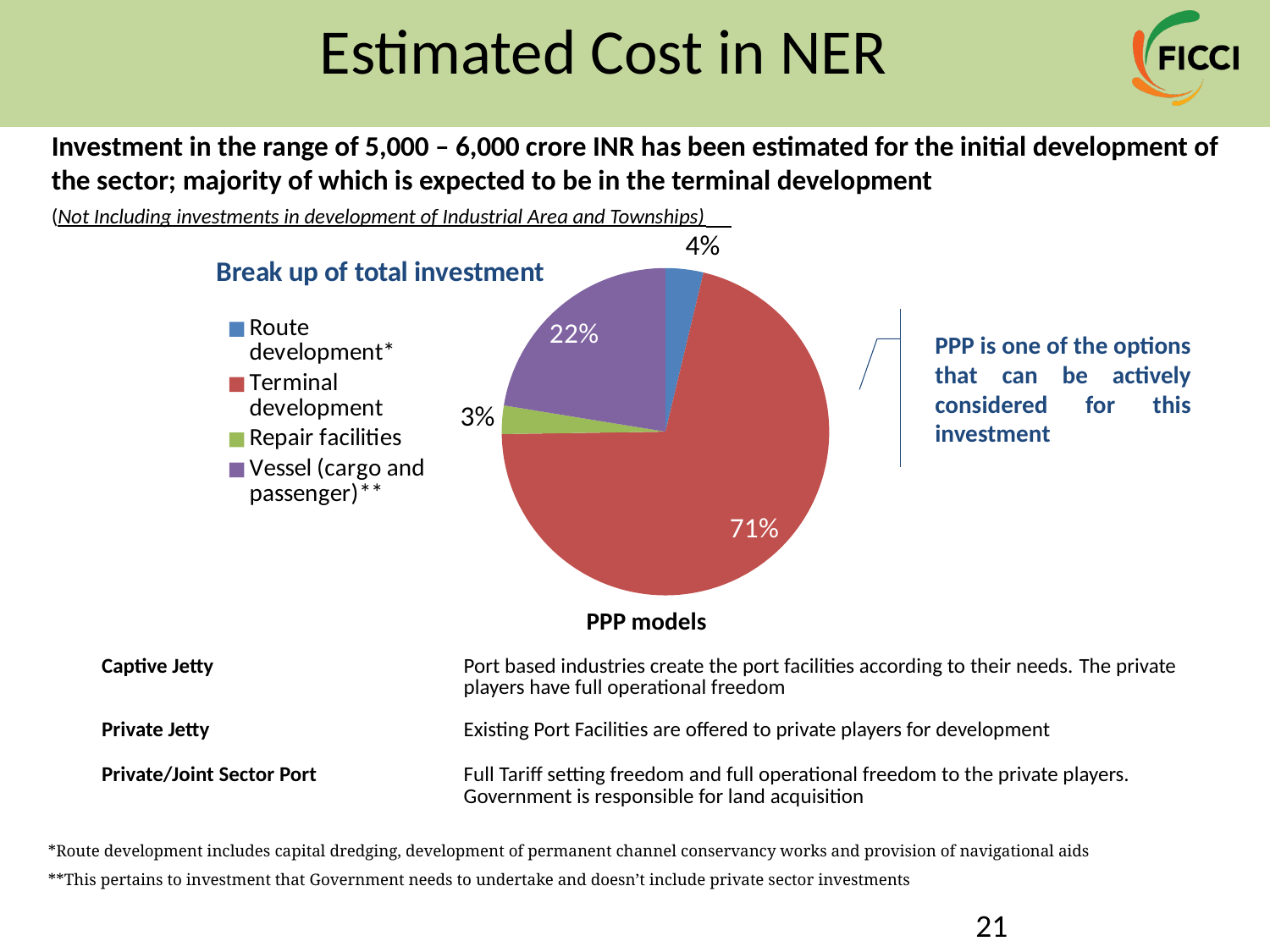
Which category has the largest share of total investment? Terminal development What kind of chart is shown on the slide? Pie chart What is the title of the chart? Break up of total investment Which category has the smallest share of total investment? Repair facilities What colour is the Terminal development slice? Red What share of total investment is Vessel (cargo and passenger)? 22% Which is larger, the share for Route development or the share for Repair facilities? Route development What share of total investment is Terminal development? 71% How many categories does the pie chart show? 4 What is the difference in percentage points between Terminal development and Vessel (cargo and passenger)? 49 percentage points What share of total investment is Route development? 4% What share of total investment is Repair facilities? 3%